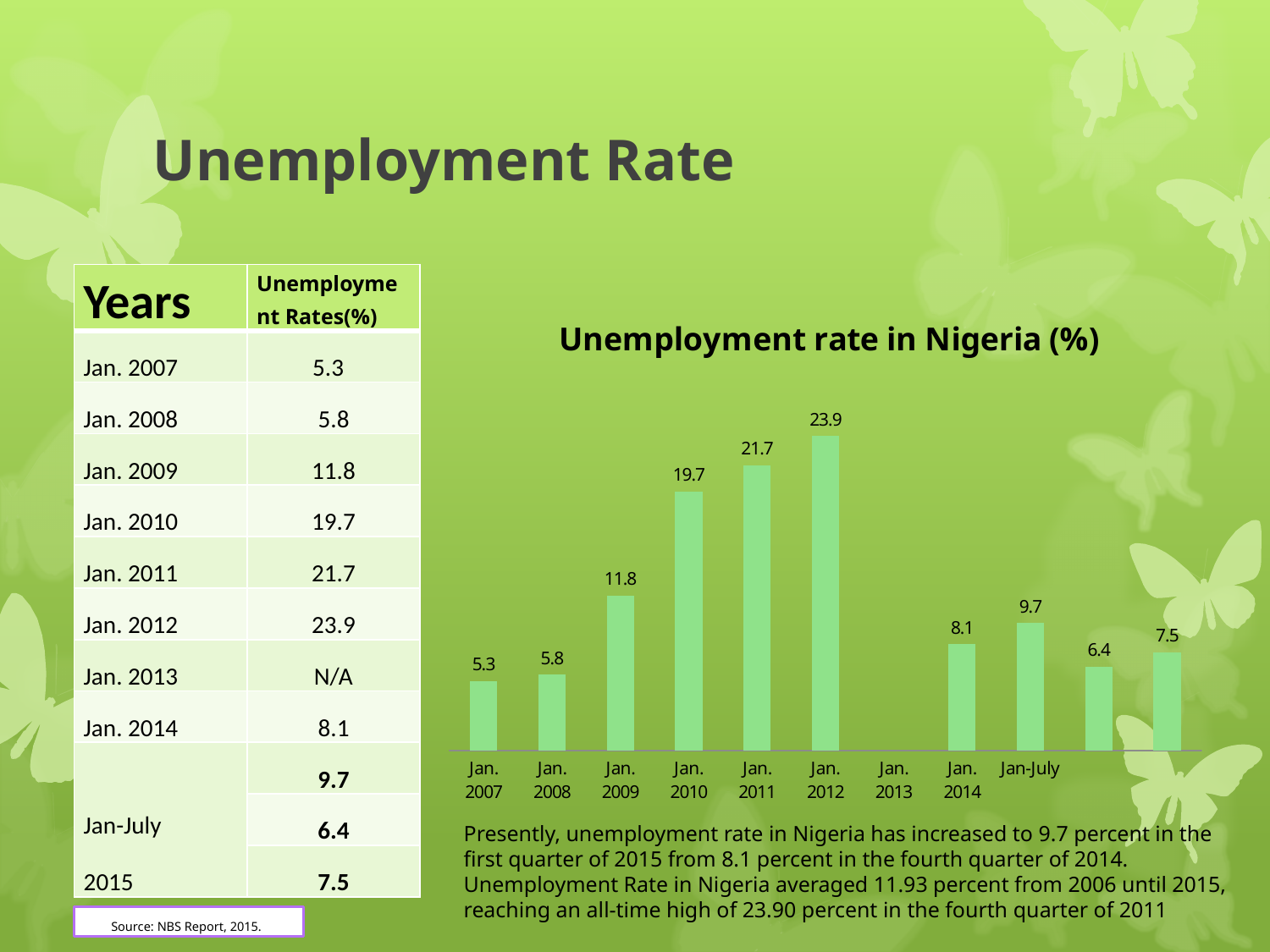
What kind of chart is shown on the slide? Bar chart What is the difference between the values for Jan. 2012 and Jan. 2011? 2.2 How many bars are plotted in the chart? 10 What is the title of the chart? Unemployment rate in Nigeria (%) Which year has the highest unemployment rate in the chart? Jan. 2012 Do the values rise or fall from Jan. 2007 to Jan. 2012? Rise What is the value of the bar for Jan. 2014? 8.1 What is the difference between the values for Jan. 2010 and Jan. 2014? 11.6 Which is larger, the value for Jan. 2008 or the value for Jan. 2014? Jan. 2014 What value does the chart show for Jan. 2009? 11.8 What is the unemployment rate shown for Jan. 2012 in the chart? 23.9 Which labelled bar has the lowest value in the chart? Jan. 2007